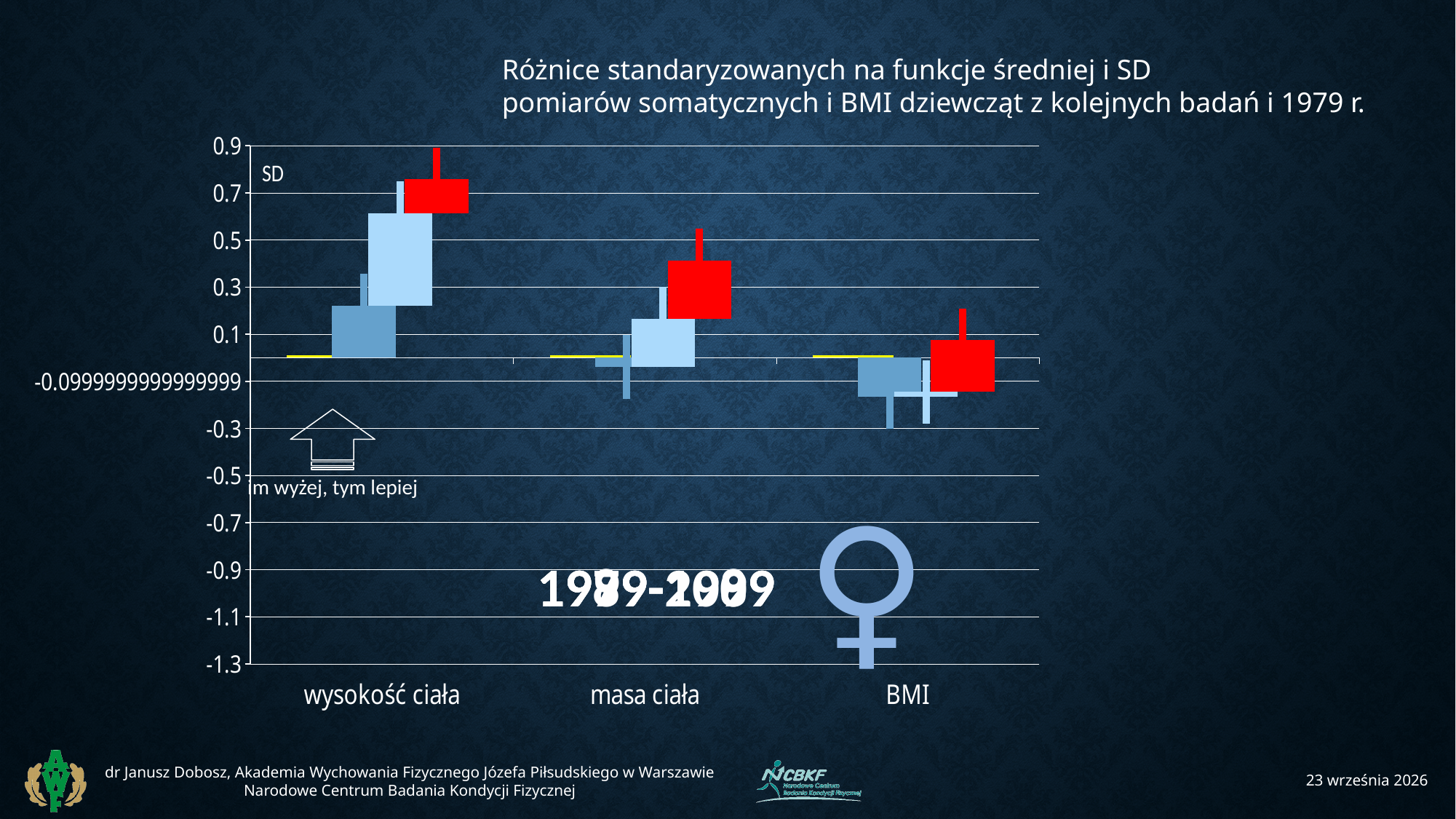
Which is higher, the red box for wysokość ciała or the red box for BMI? wysokość ciała Which category has the lowest red box? BMI Is the red box for wysokość ciała greater or less than 0.5? greater Is the light blue box for wysokość ciała greater or less than 0.1? greater What are the three categories on the x axis of the chart? wysokość ciała, masa ciała, BMI What is the title of the chart? Różnice standaryzowanych na funkcje średniej i SD pomiarów somatycznych i BMI dziewcząt z kolejnych badań i 1979 r. Do the red boxes rise or fall from wysokość ciała to BMI along the x axis? fall Is the red box for masa ciała greater or less than 0.1? greater How many categories are shown on the x axis of the chart? 3 Which category has the highest red box? wysokość ciała